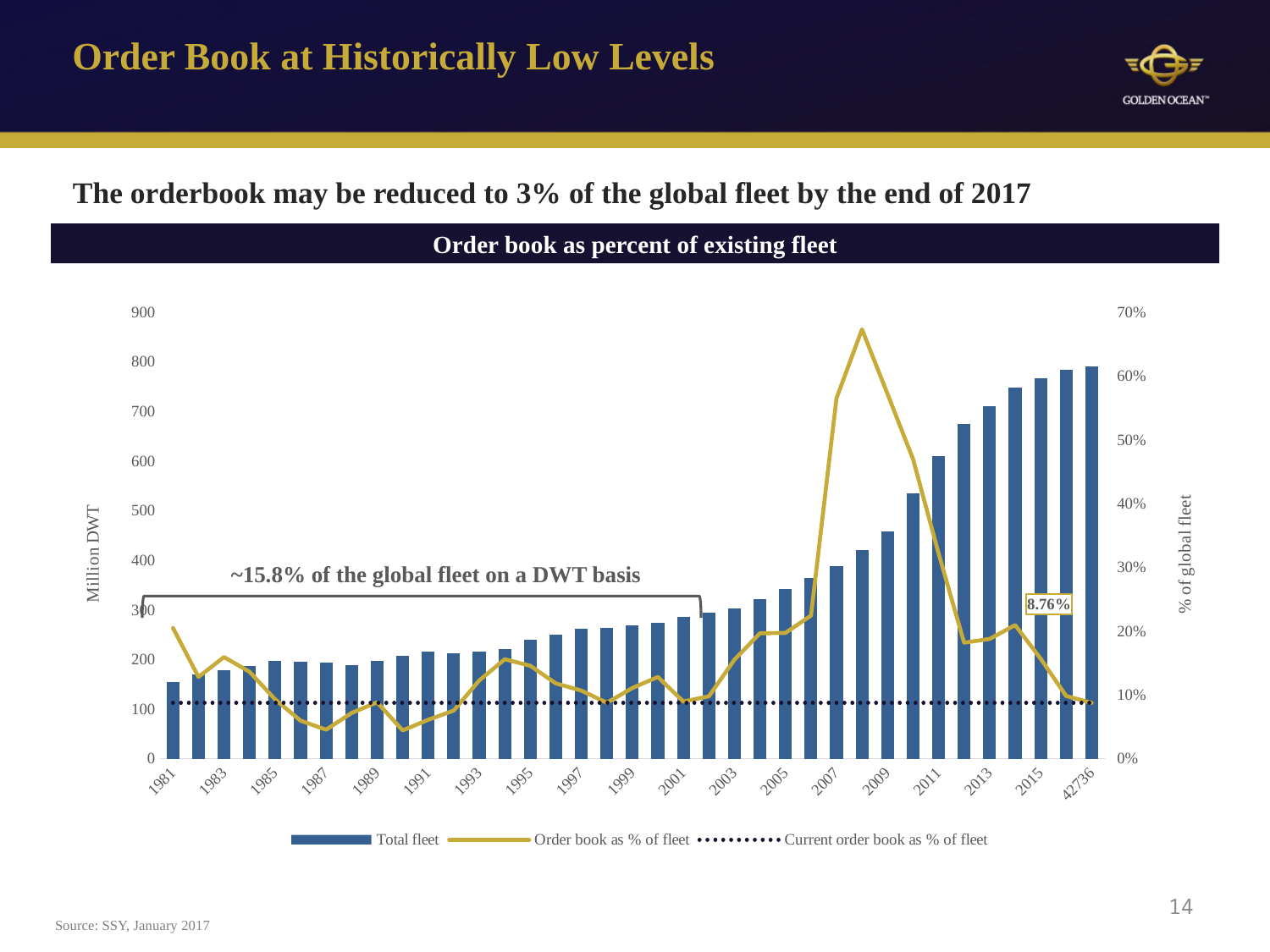
How many series does the chart legend list? 3 What kind of chart is shown on the slide? A combined bar and line chart What is the title of the chart? Order book as percent of existing fleet Is the total fleet in 2009 greater or less than 400 million DWT? greater Do the total fleet bars generally rise or fall from 1981 to the end of the x axis? rise Is the total fleet in 1981 greater or less than 200 million DWT? less What is the label of the left vertical axis? Million DWT Which is larger, the total fleet in 2011 or in 2005? 2011 Is the order book as % of fleet in 2008 greater or less than 60%? greater What value is printed in the data label on the chart? 8.76% In which year does the order book as % of fleet reach its highest point? 2008 Which year has the lowest total fleet? 1981